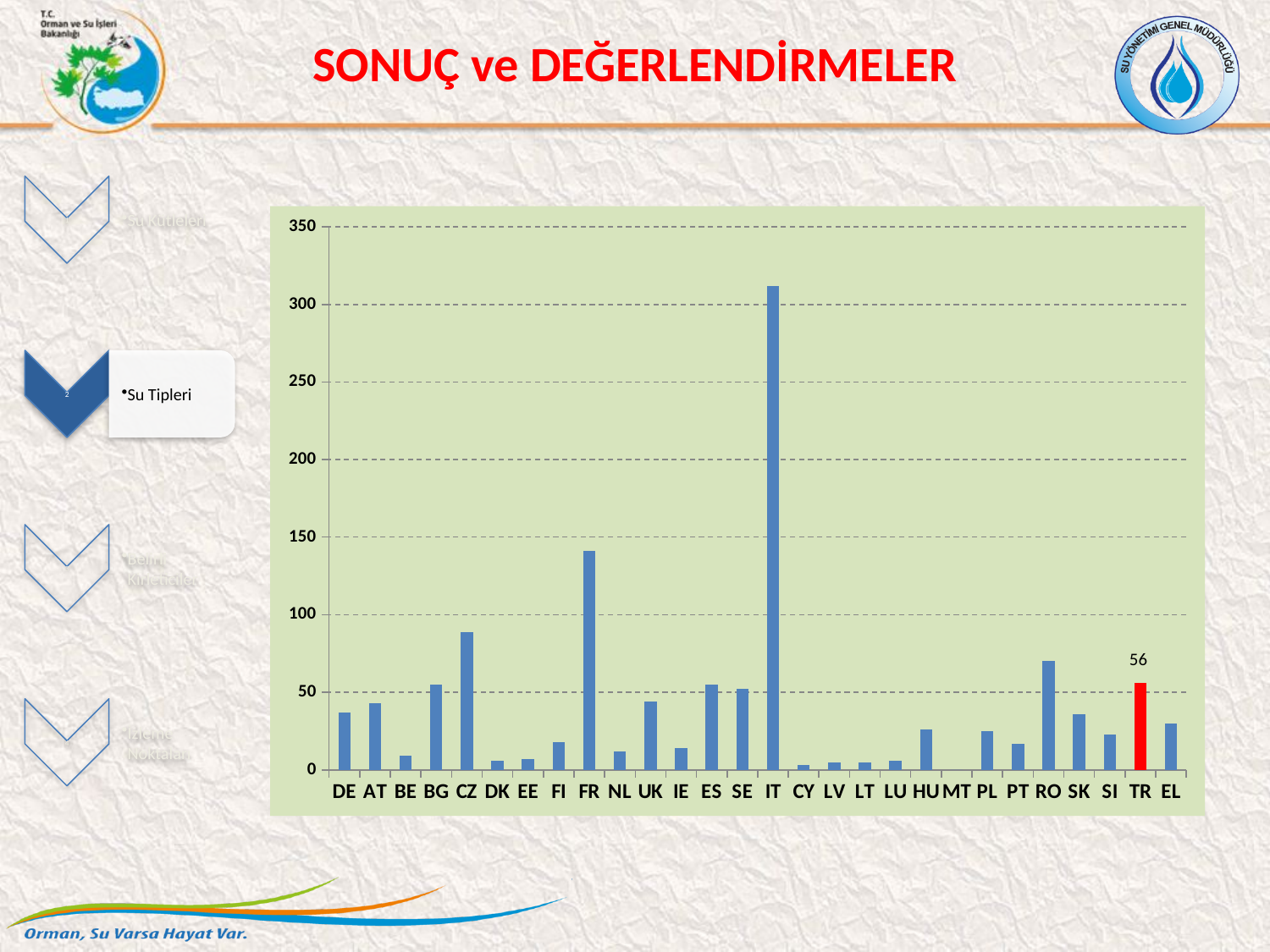
How many categories are shown on the x axis? 28 Is the value for DE greater or less than 50? less What kind of chart is shown on the slide? bar chart Which is larger, the value for FR or the value for CZ? FR Which category has the highest value? IT Which is larger, the value for RO or the value for TR? RO Is the value for IT greater or less than 300? greater Is the value for FR greater or less than 100? greater Which category has the lowest value? MT What is the value for TR? 56